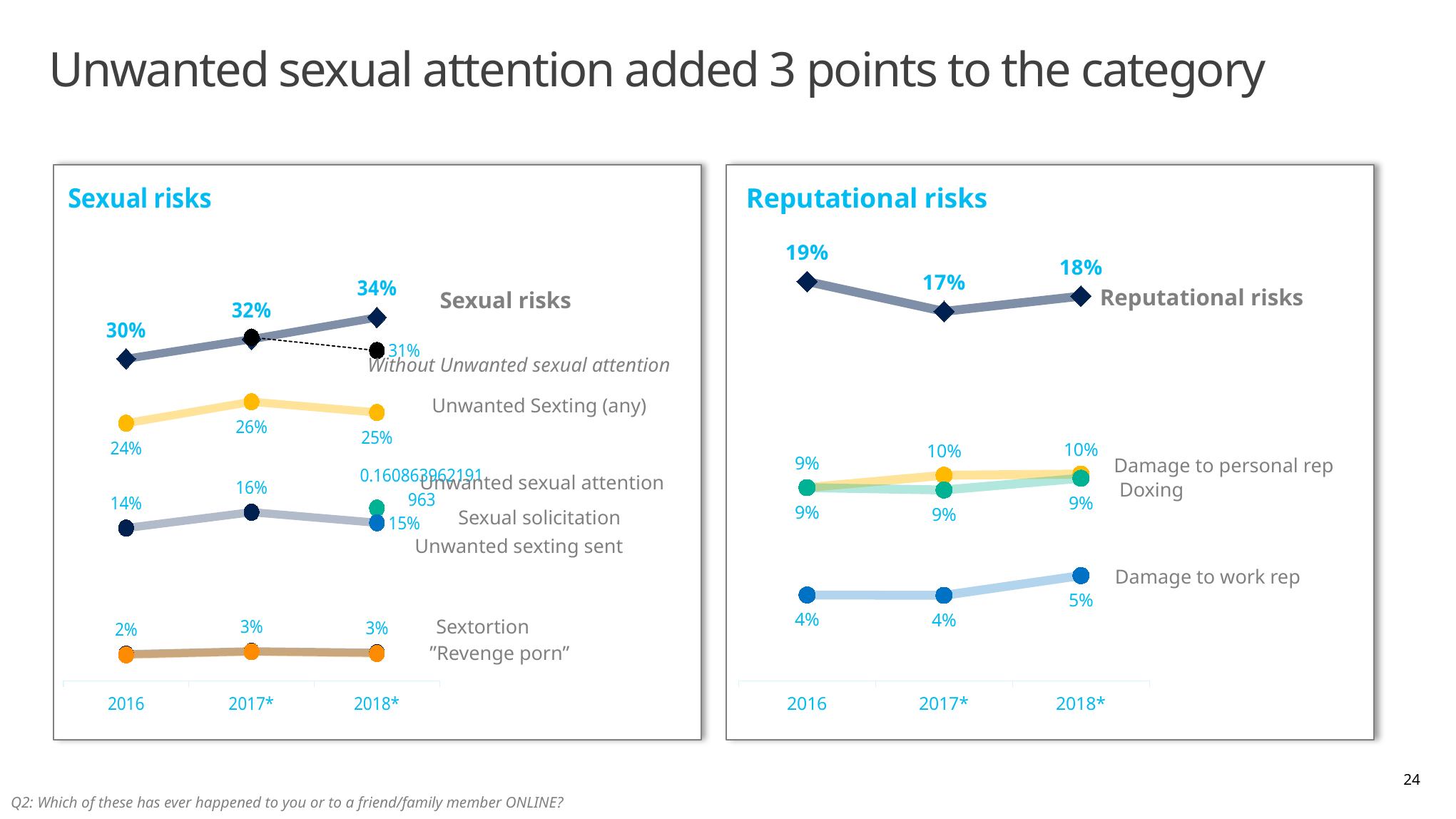
In the Sexual risks chart, what is the value of the Sexual risks line in 2016? 30% In the Sexual risks chart, what is the 2018* value labelled 'Without Unwanted sexual attention'? 31% In the Sexual risks chart, what is the value of the Sexual risks line in 2018*? 34% In the Reputational risks chart, what is the value for Damage to work rep in 2018*? 5% In the Sexual risks chart, does the Sexual risks line rise or fall from 2016 to 2018*? rise In the Sexual risks chart, what is the value for Unwanted Sexting (any) in 2017*? 26% In the Reputational risks chart, which year has the highest value for the Reputational risks line? 2016 What type of chart is the Reputational risks chart? line chart In the Reputational risks chart, which is larger in 2018*: Damage to personal rep or Damage to work rep? Damage to personal rep In the Reputational risks chart, what is the value of the Reputational risks line in 2017*? 17% In the Reputational risks chart, what is the difference between the Reputational risks line in 2016 and 2017*? 2 percentage points In the Sexual risks chart, by how many percentage points did the Sexual risks line rise from 2016 to 2018*? 4 percentage points